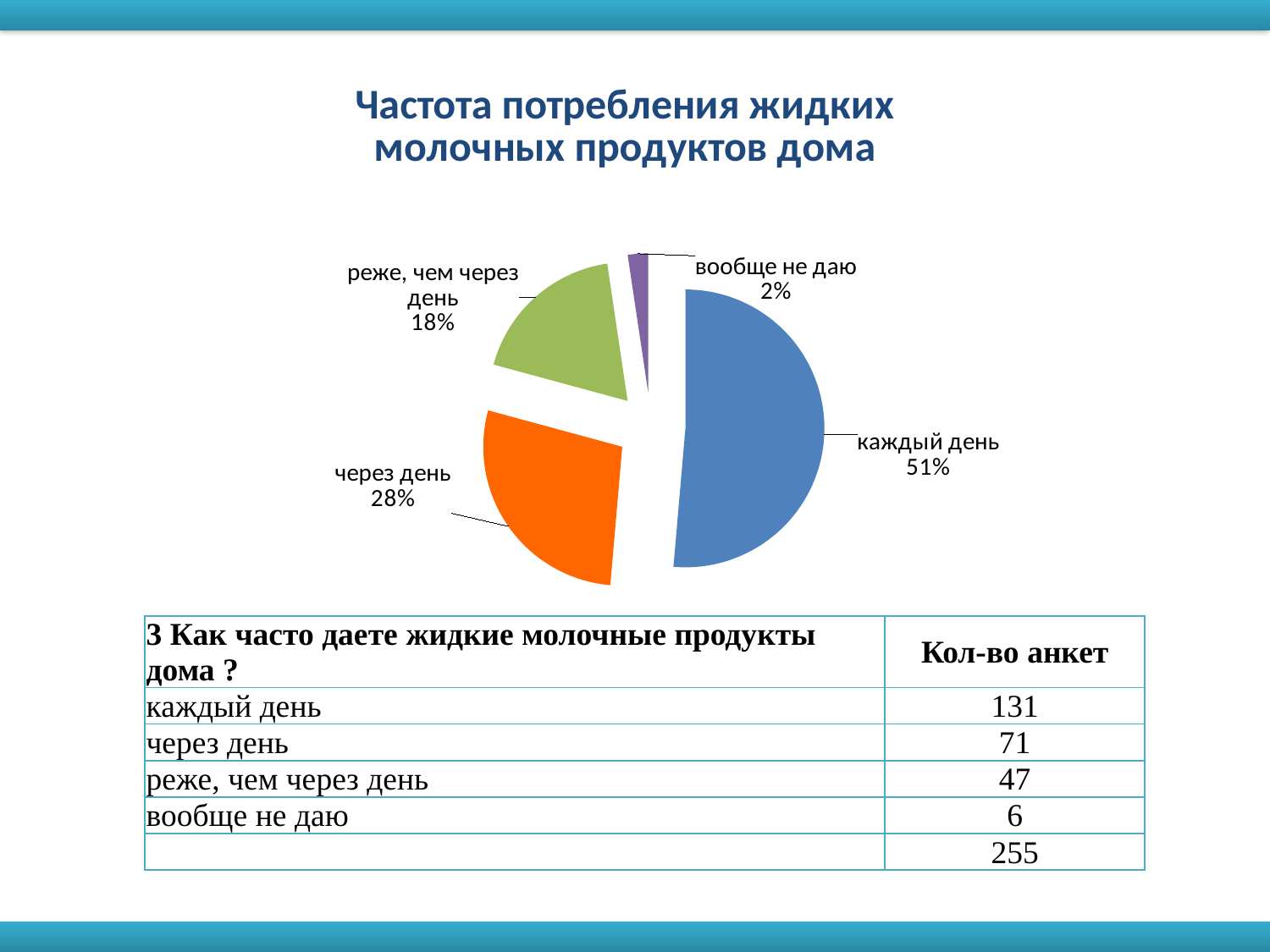
What colour is the "каждый день" slice? blue How many slices does the pie chart have? 4 Which slice is larger: "через день" or "реже, чем через день"? через день What share of the pie does "через день" have? 28% What share of the pie does "реже, чем через день" have? 18% Which category has the smallest slice of the pie? вообще не даю What kind of chart is shown on the slide? pie chart What share of the pie does "каждый день" have? 51% Which category has the largest slice of the pie? каждый день What is the title of the chart? Частота потребления жидких молочных продуктов дома What is the difference in percentage points between the "каждый день" and "через день" slices? 23